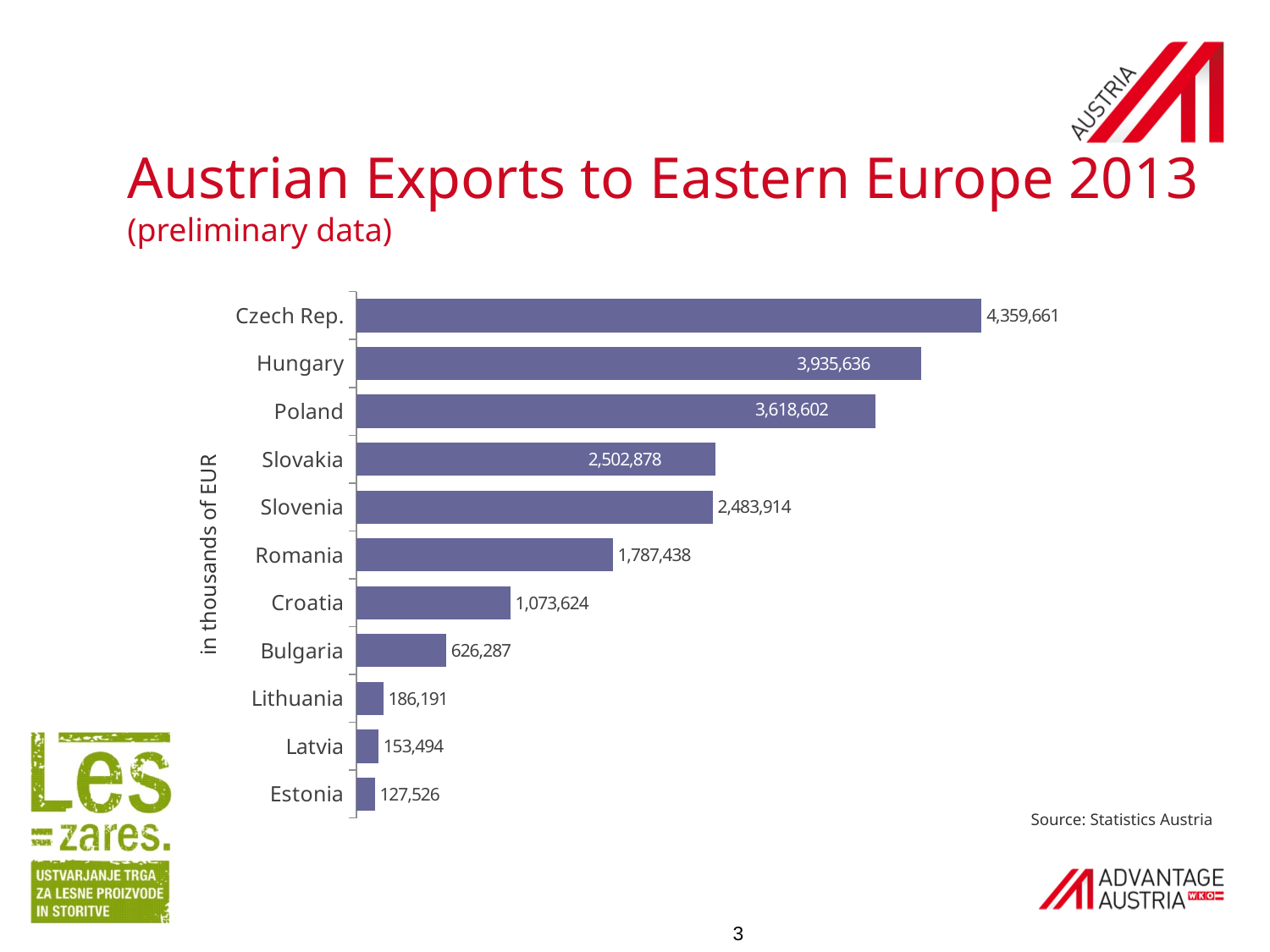
Which is larger, the value for Croatia or the value for Bulgaria? Croatia Which country has the highest value? Czech Rep. What is the value for Czech Rep.? 4,359,661 How many countries are shown in the chart? 11 Which is larger, the value for Slovakia or the value for Slovenia? Slovakia What is the difference between the values for Czech Rep. and Hungary? 424,025 What is the difference between the values for Lithuania and Latvia? 32,697 What kind of chart is shown on the slide? Bar chart What is the value for Romania? 1,787,438 What unit is given on the chart's axis label? in thousands of EUR What is the value for Bulgaria? 626,287 Which country has the lowest value? Estonia